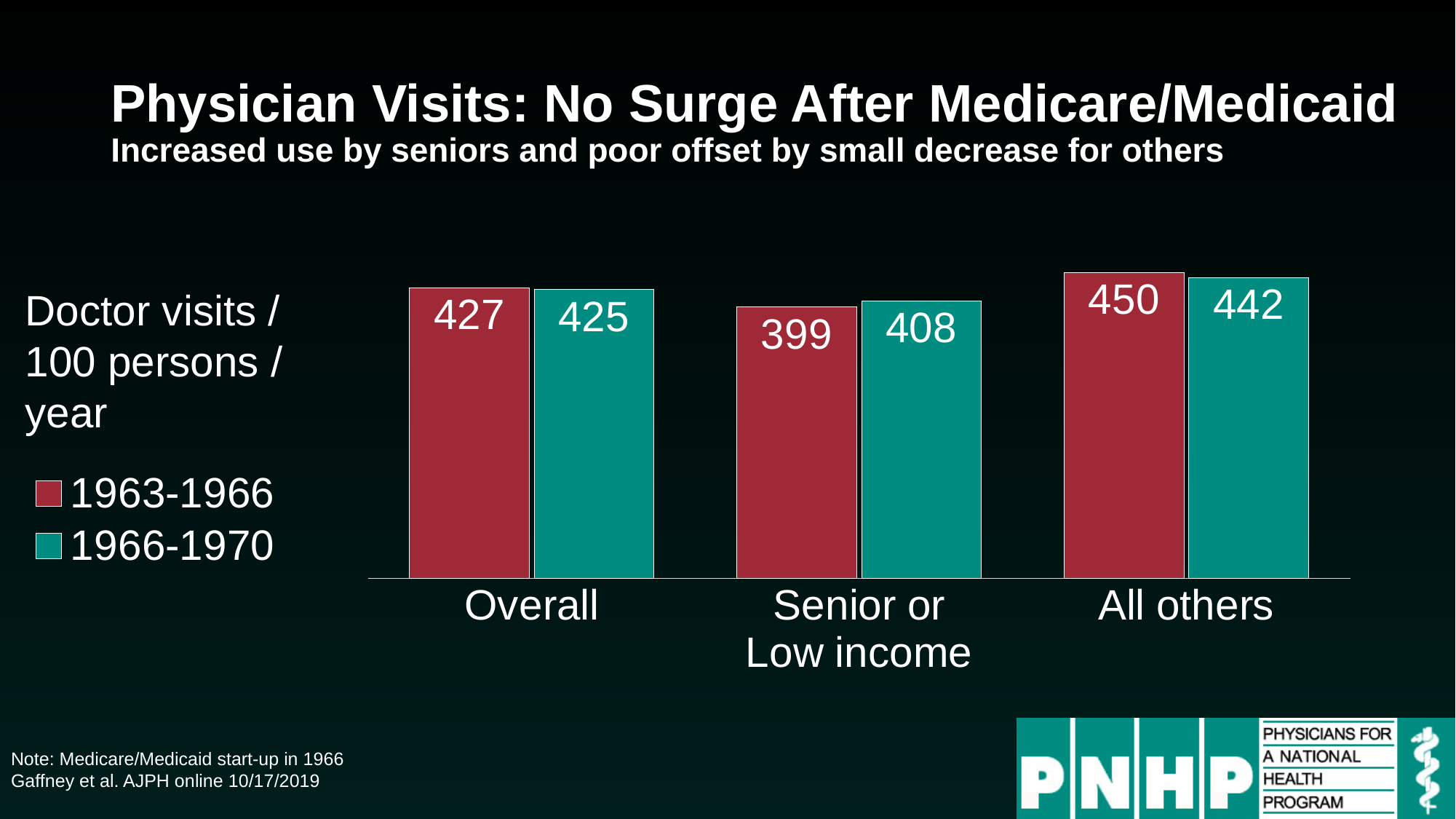
What is the value for Overall in the 1963-1966 series? 427 What is the difference between the 1966-1970 and 1963-1966 values for Senior or Low income? 9 What is the value for Overall in the 1966-1970 series? 425 What is the value for All others in the 1963-1966 series? 450 How many categories are shown on the x axis? 3 What is the difference between the 1963-1966 and 1966-1970 values for All others? 8 What is the value for Senior or Low income in the 1966-1970 series? 408 What kind of chart is shown on the slide? Bar chart For Senior or Low income, which series has the larger value, 1963-1966 or 1966-1970? 1966-1970 Which category has the highest value in the 1966-1970 series? All others How many series does the legend list? 2 Which category has the lowest value in the 1963-1966 series? Senior or Low income